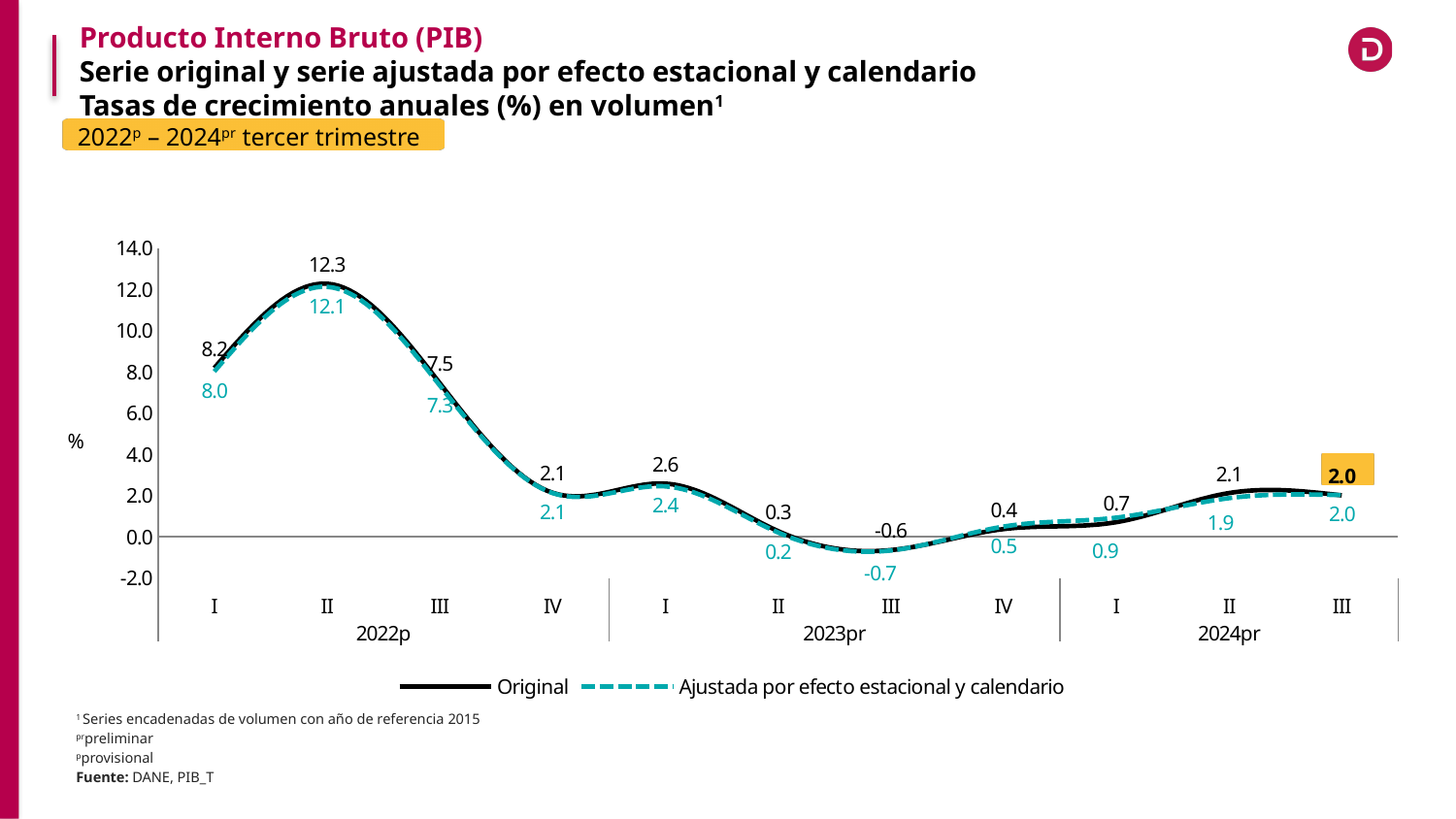
What is the value of the Original series for quarter III of 2024pr? 2.0 How many quarters are plotted along the x axis? 11 What is the value of the Ajustada por efecto estacional y calendario series for quarter I of 2023pr? 2.4 In which quarter does the Original series reach its highest value? II 2022p What is the value of the Original series for quarter II of 2022p? 12.3 Which is larger for quarter I of 2024pr: the Original value or the Ajustada por efecto estacional y calendario value? Ajustada por efecto estacional y calendario What is the value of the Ajustada por efecto estacional y calendario series for quarter III of 2023pr? -0.7 Does the Original series rise or fall from quarter II of 2022p to quarter IV of 2022p? fall What type of chart is shown on the slide? line chart What is the difference between the Original value for quarter I of 2022p (8.2) and the Ajustada value for the same quarter (8.0)? 0.2 How many series does the legend list? 2 In which quarter does the Original series reach its lowest value? III 2023pr